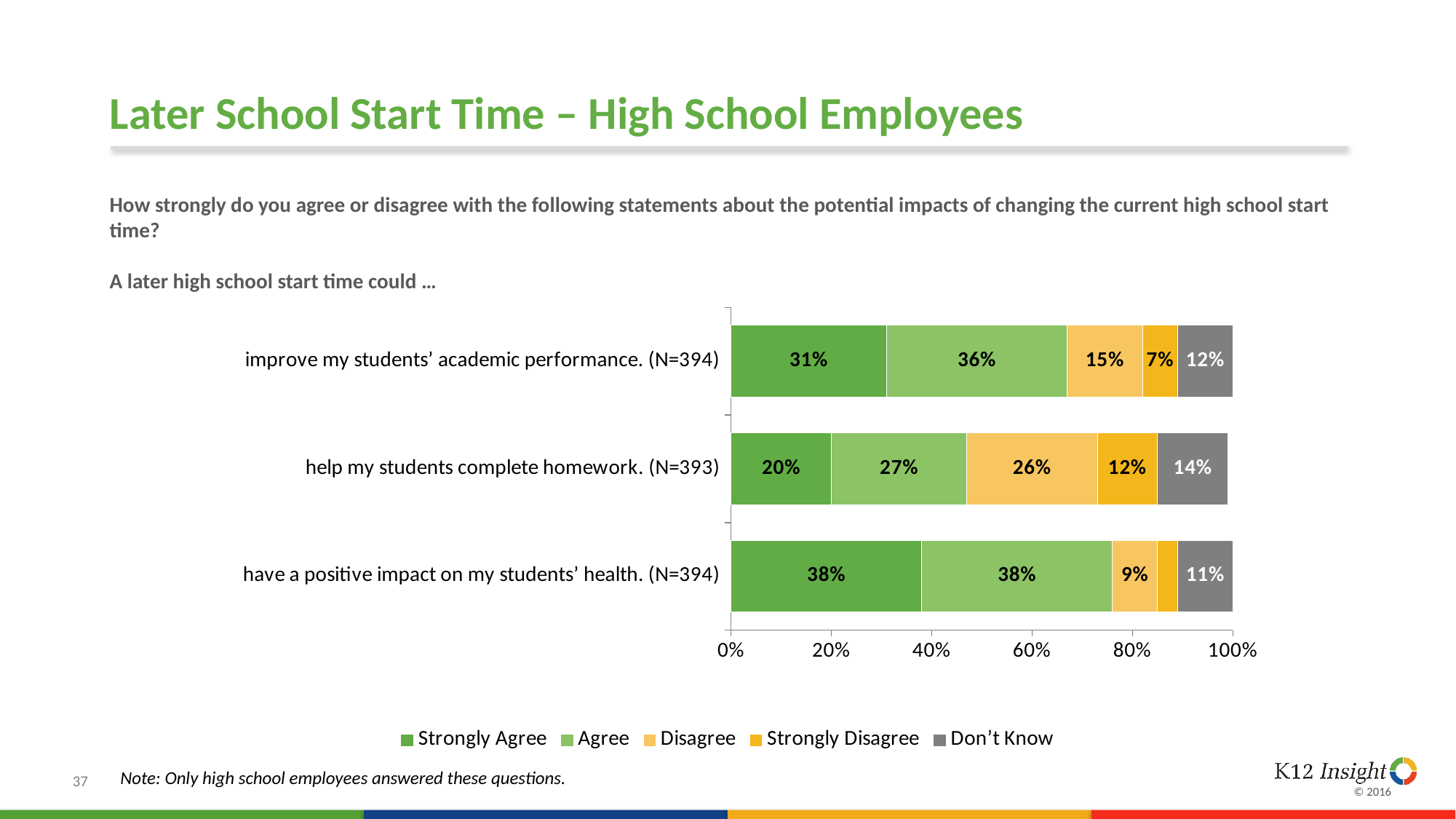
What is the difference between the 'Disagree' percentages for 'help my students complete homework' and 'improve my students' academic performance'? 11% What percentage of respondents disagree that a later start time could help their students complete homework? 26% Which colour represents the 'Don't Know' responses in the chart? Grey Which statement has the lowest 'Agree' percentage? help my students complete homework. (N=393) Is the 'Strongly Disagree' percentage larger for 'help my students complete homework' or for 'improve my students' academic performance'? help my students complete homework. (N=393) How many statements are plotted in the chart? 3 What percentage answered 'Don't Know' for the statement that a later start time could have a positive impact on students' health? 11% Which statement has the highest 'Strongly Agree' percentage? have a positive impact on my students' health. (N=394) What percentage of high school employees strongly agree that a later start time could improve their students' academic performance? 31% What is the combined 'Strongly Agree' and 'Agree' percentage for the statement about a positive impact on students' health? 76% How many response categories does the legend list? 5 What type of chart is shown on the slide? Stacked bar chart